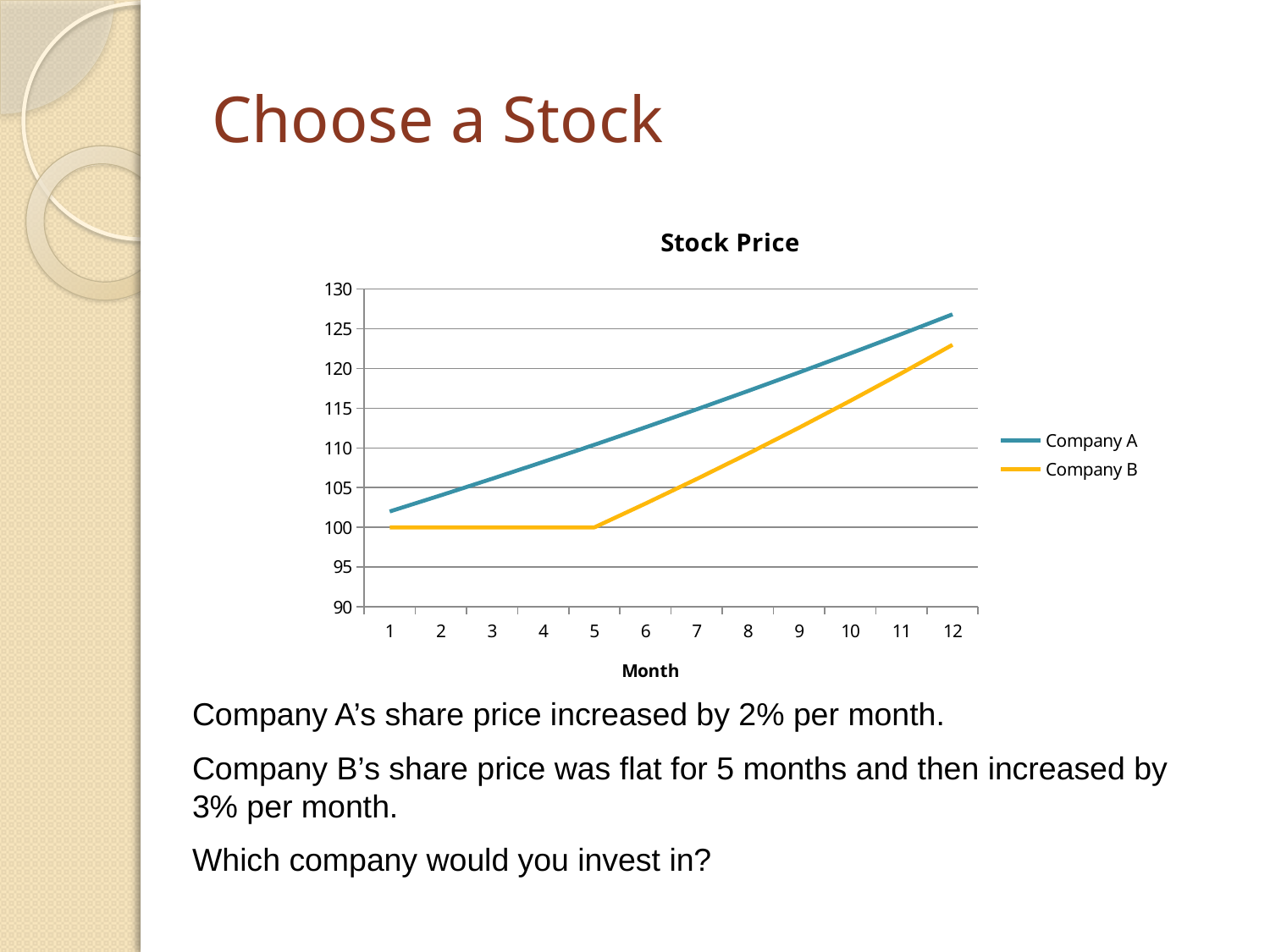
Is the value for Company A in month 12 greater or less than 125? greater How many months are shown on the x axis? 12 What kind of chart is shown on the slide? line chart What is the value for Company B in month 3? 100 In month 12, which company has the higher stock price, Company A or Company B? Company A What is the title of the chart? Stock Price Does the Company A line rise or fall from month 1 to month 12? rise What is the value for Company B in month 5? 100 Is the value for Company A in month 6 greater or less than 110? greater Is the value for Company B in month 12 greater or less than 125? less How many series does the legend list? 2 What is the label of the x axis? Month